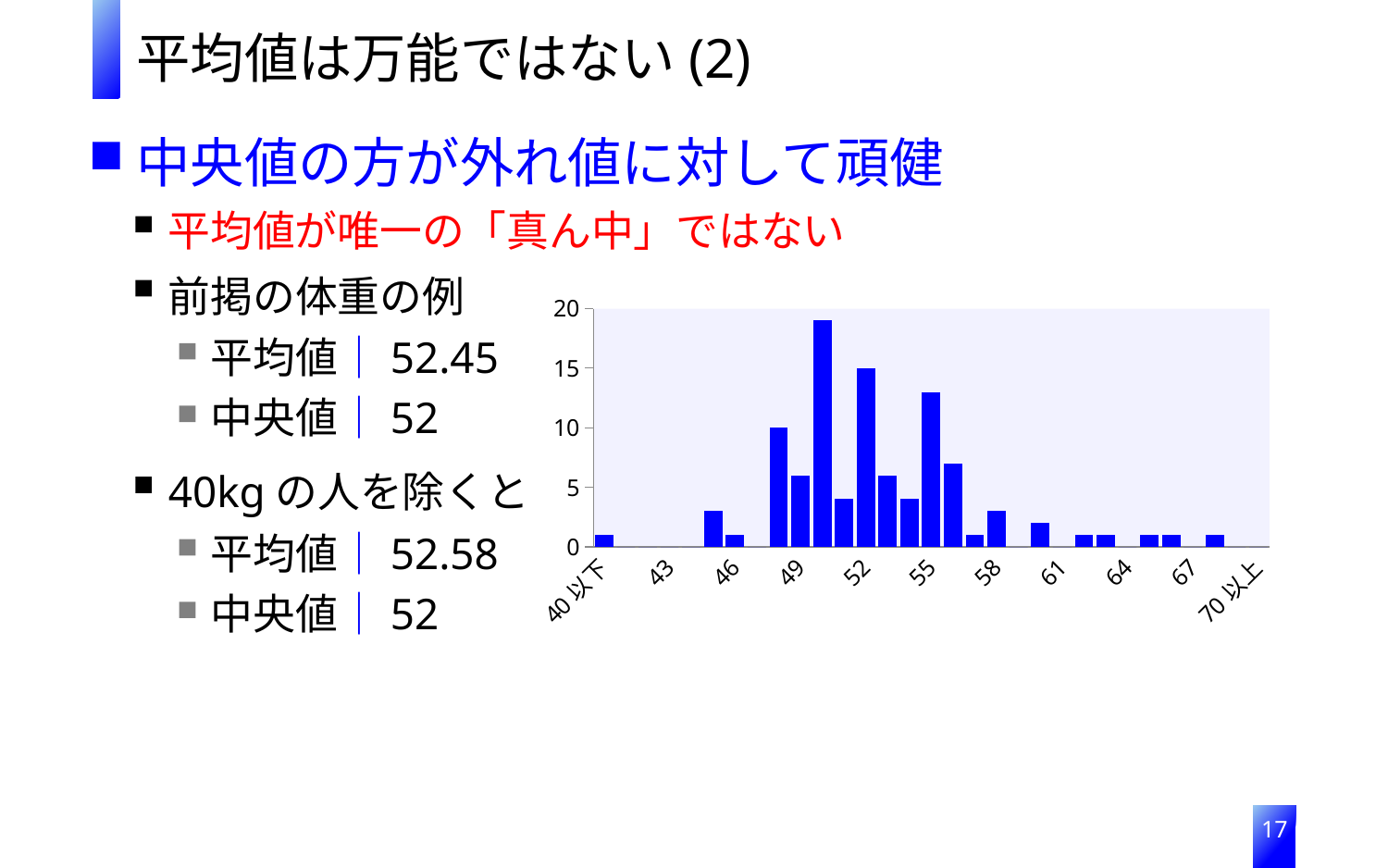
Is the tallest bar in the chart greater or less than 15? greater What kind of chart is shown on the slide? bar chart What is the highest value shown on the y axis of the chart? 20 Is the value of the bar at 55 greater or less than 10? greater Is the tallest bar in the chart greater or less than 20? less What is the value of the bar at the x-axis label 52? 15 How many category labels are shown along the x axis of the chart? 11 Which has the taller bar, the category 52 or the category 55? 52 Which has the taller bar, the category 49 or the category 58? 49 What colour are the bars in the chart? blue